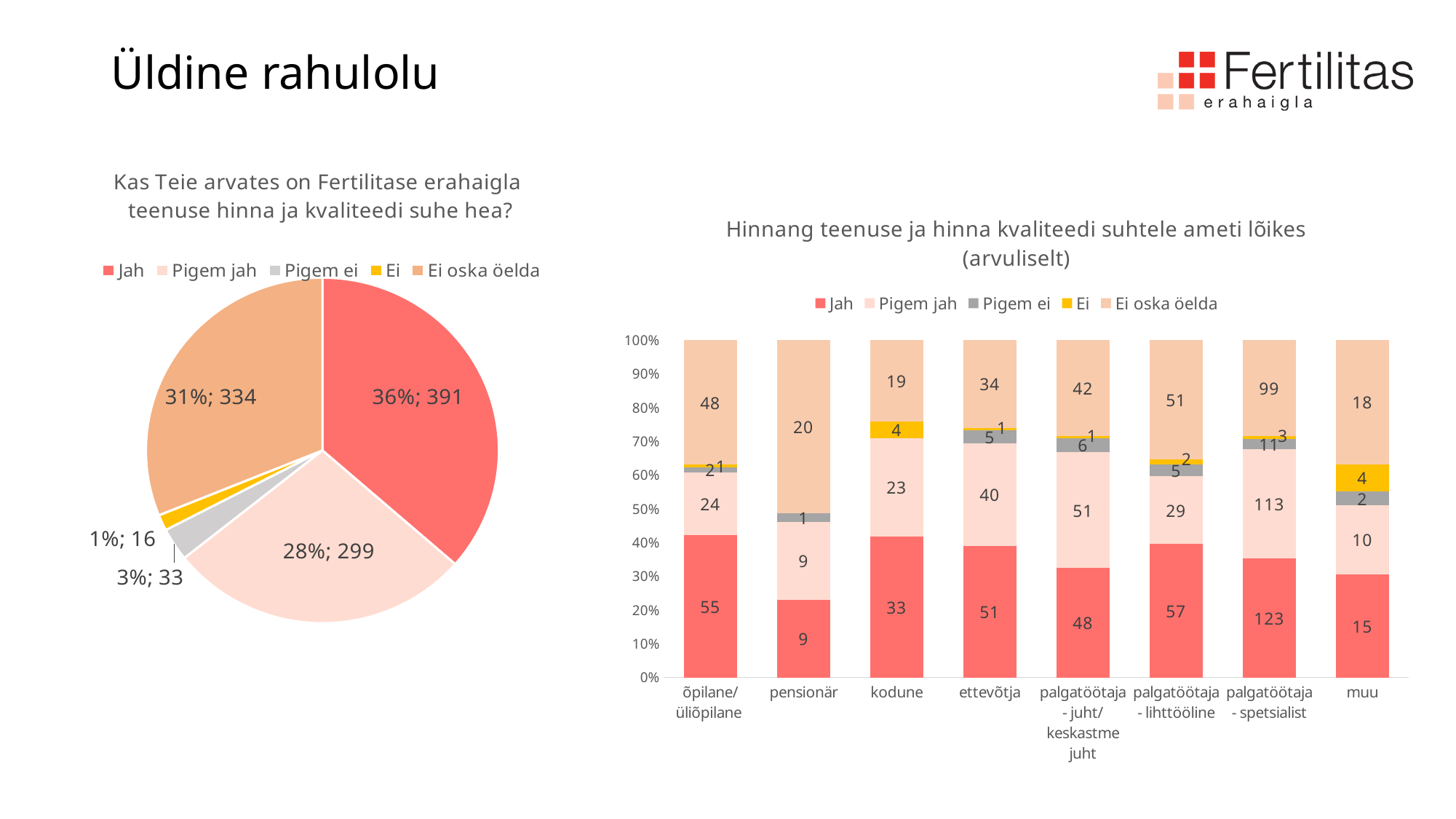
How many series does the legend of the pie chart on the left list? 5 In the pie chart on the left, which category has the smallest slice? Ei In the pie chart on the left, how many more responses are 'Jah' than 'Pigem jah'? 92 In the chart on the right, which is larger for 'ettevõtja': the 'Jah' count or the 'Pigem jah' count? Jah In the chart on the right, what is the 'Jah' value for 'palgatöötaja - spetsialist'? 123 In the chart on the right, what is the total number of responses in the 'muu' bar? 49 In the chart on the right, which category has the highest 'Jah' count? palgatöötaja - spetsialist In the chart on the right, what is the 'Ei oska öelda' value for 'pensionär'? 20 In the pie chart on the left, what share of responses is 'Ei oska öelda'? 31% In the pie chart on the left, what value is shown for the 'Jah' slice? 36%; 391 In the chart on the right, how many occupation categories are shown on the x axis? 8 What kind of chart is the chart on the right, 'Hinnang teenuse ja hinna kvaliteedi suhtele ameti lõikes'? Stacked bar chart